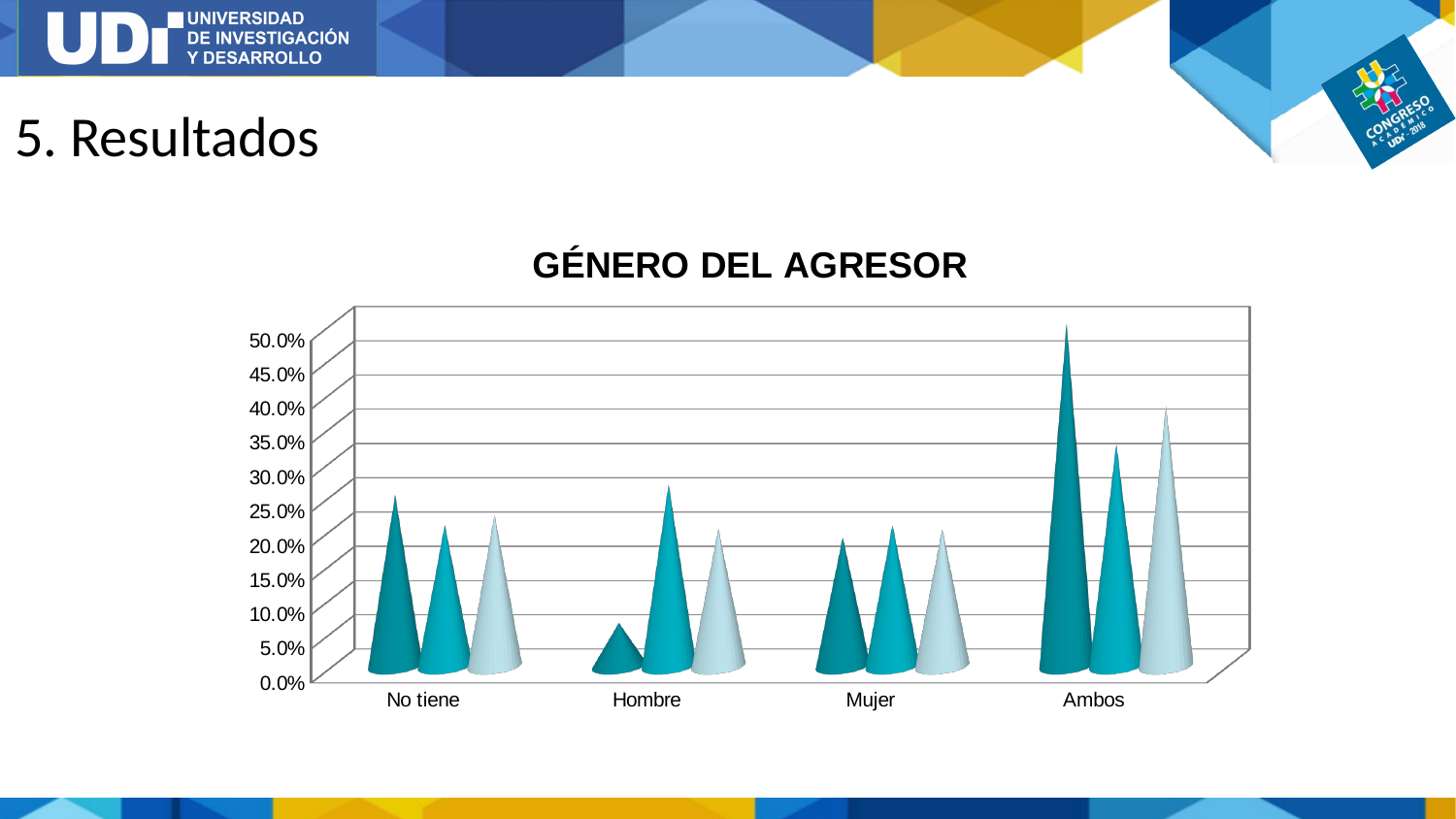
Are all three bars for Mujer greater or less than 30.0%? less Is the tallest bar for Ambos greater or less than 40.0%? greater Is the shortest bar for Hombre greater or less than 10.0%? less How many categories are shown on the x axis of the chart? 4 What kind of chart is shown on the slide? bar chart Which category contains the shortest bar in the chart? Hombre Which is larger: the first bar for No tiene or the first bar for Hombre? No tiene What is the highest value shown on the y axis of the chart? 50.0% What is the title of the chart? GÉNERO DEL AGRESOR Which category contains the tallest bar in the chart? Ambos How many bars are plotted for each category in the chart? 3